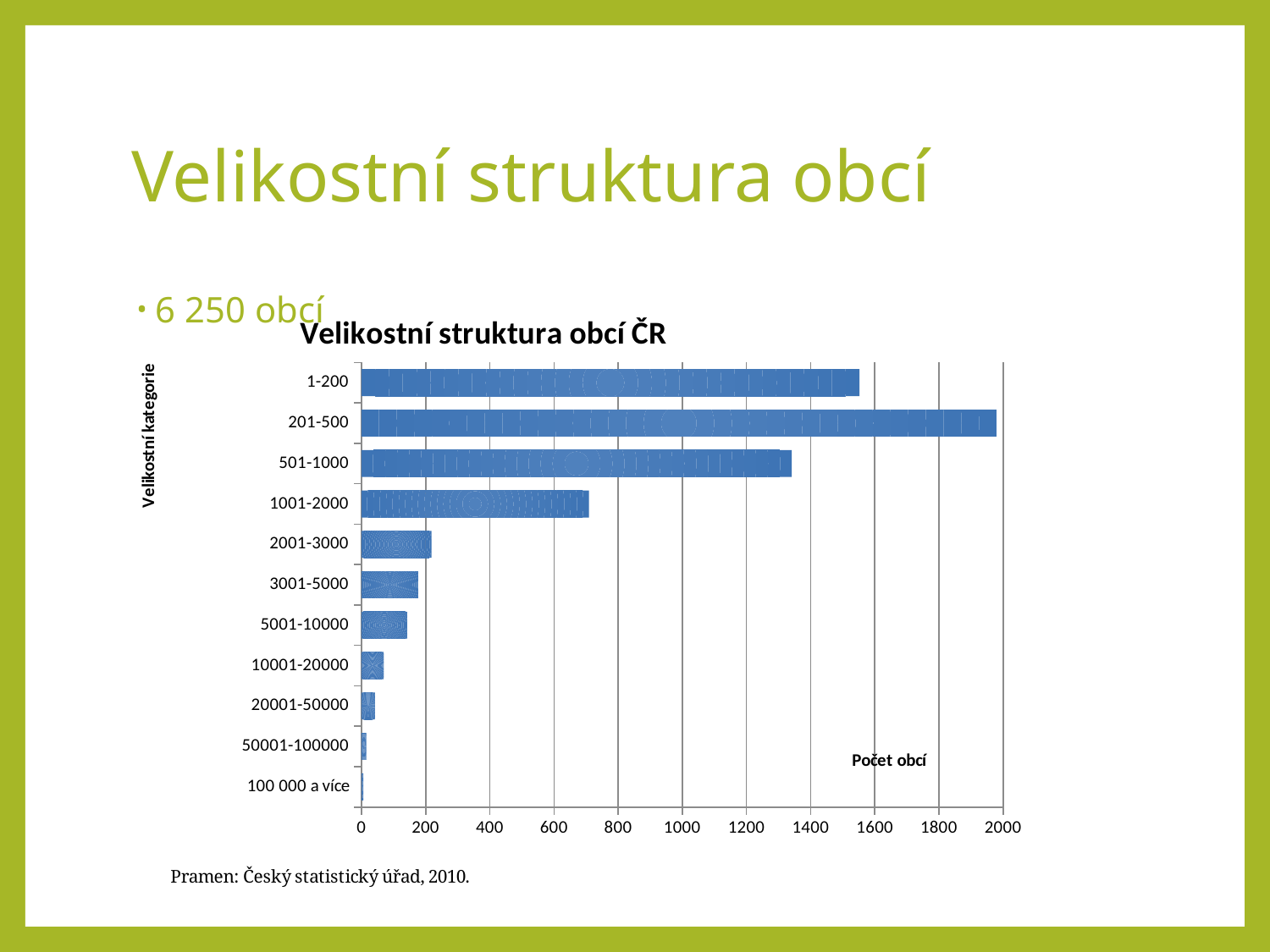
What is the title of the chart? Velikostní struktura obcí ČR Is the value for the 201-500 category greater or less than 1800? greater What kind of chart is shown on the slide? bar chart Which size category has the highest number of municipalities (Počet obcí)? 201-500 How many size categories are plotted in the chart? 11 Is the value for the 5001-10000 category greater or less than 200? less Is the value for the 501-1000 category greater or less than 1200? greater Which size category has the lowest number of municipalities? 100 000 a více What is the label of the vertical axis of the chart? Velikostní kategorie Which has more municipalities: the 1-200 category or the 501-1000 category? 1-200 Which has more municipalities: the 1001-2000 category or the 2001-3000 category? 1001-2000